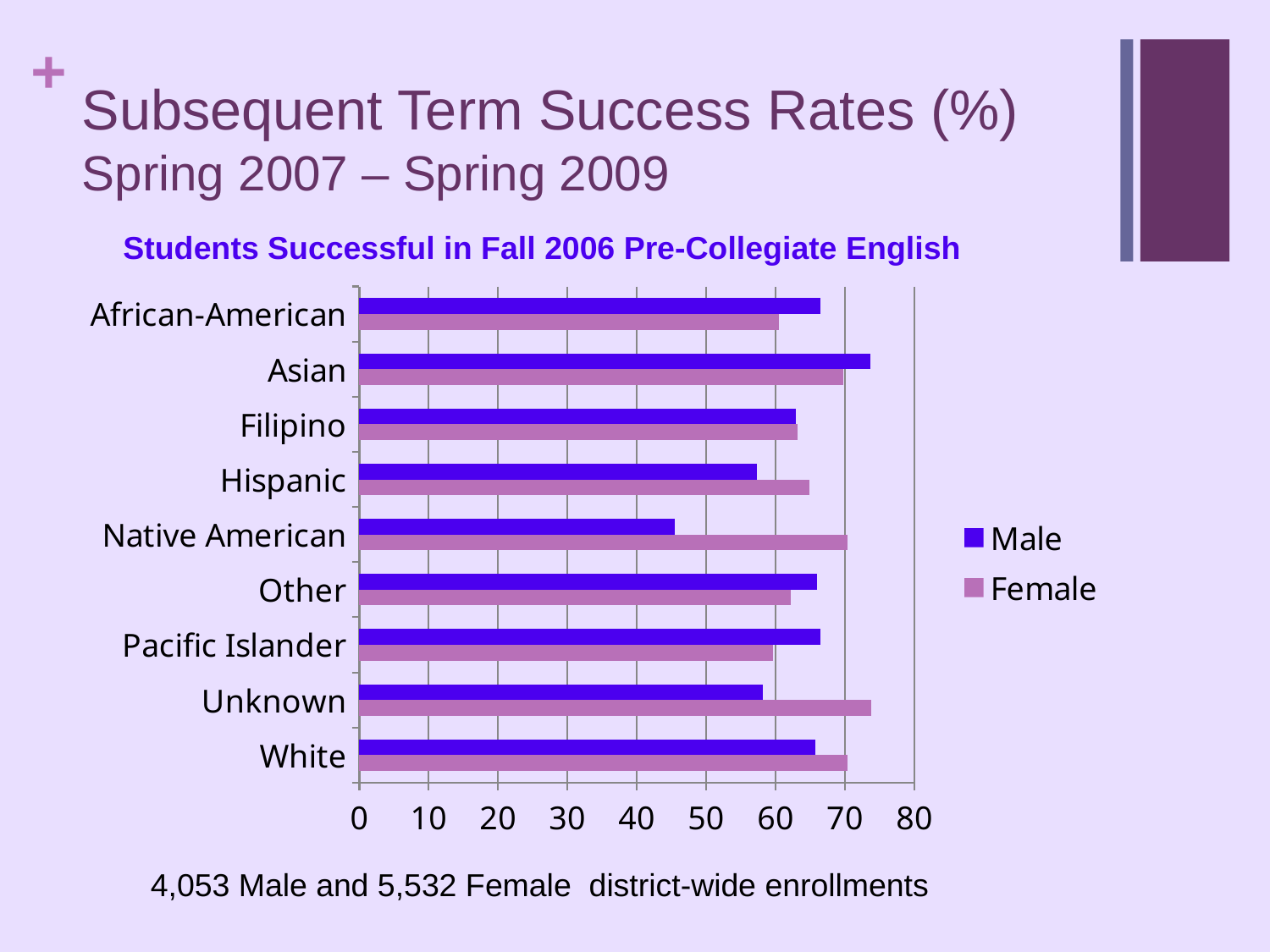
What is the title shown above the chart? Students Successful in Fall 2006 Pre-Collegiate English How many ethnic categories are plotted on the chart? 9 How many series does the legend list? 2 Which category has the highest Female success rate? Unknown Which category has the highest Male success rate? Asian Is the Male value for Native American greater or less than 50? less Which category has the lowest Male success rate? Native American For Native American students, is the Male or Female success rate larger? Female What kind of chart is shown on the slide? Bar chart For Unknown students, is the Male or Female success rate larger? Female For Asian students, is the Male or Female success rate larger? Male Is the Female value for Unknown greater or less than 70? greater